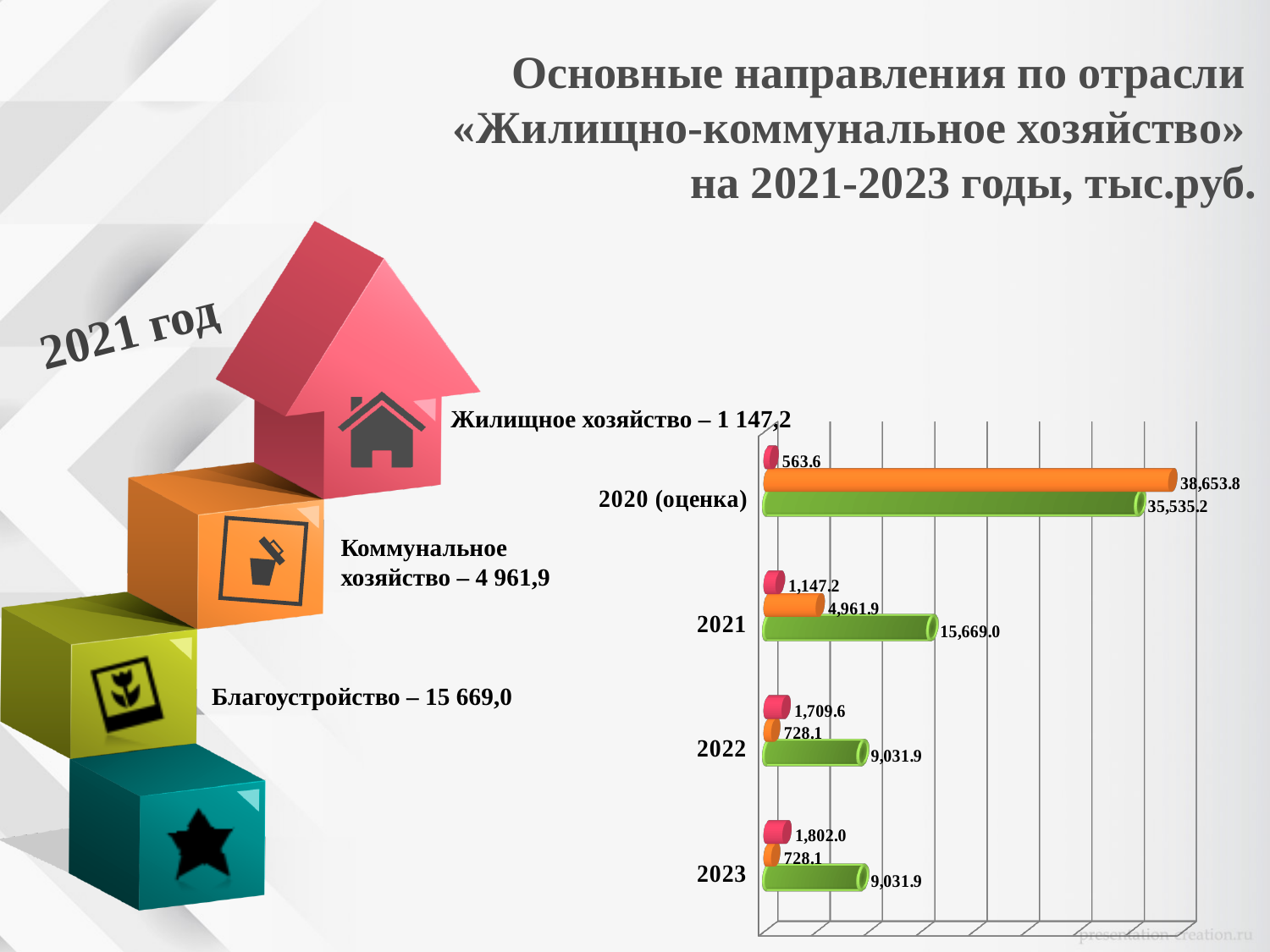
What is the difference between the orange bar and the green bar for 2020 (оценка)? 3,118.6 What is the difference between the pink bar for 2023 and the pink bar for 2022? 92.4 Do the green bar values rise or fall from 2020 (оценка) to 2023? fall How many categories (years) are shown on the chart? 4 Which category has the lowest pink bar? 2020 (оценка) What is the value of the pink bar for 2023? 1,802.0 What is the value of the green bar for 2021? 15,669.0 Which category has the highest green bar? 2020 (оценка) What is the value of the orange bar for 2020 (оценка)? 38,653.8 For 2022, which is larger: the pink bar or the orange bar? the pink bar What kind of chart is shown on the slide? bar chart What is the value of the orange bar for 2022? 728.1